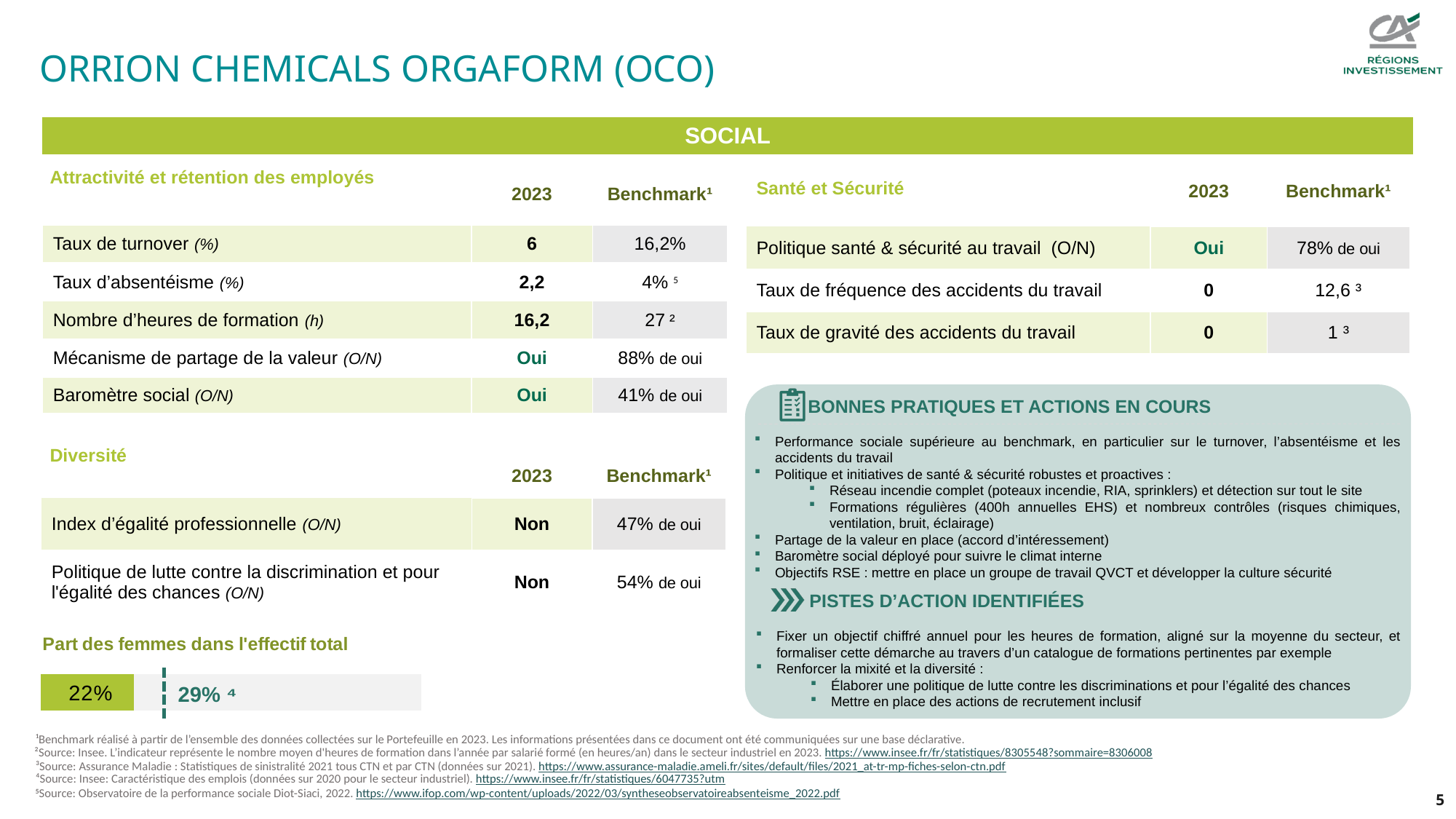
In the 'Part des femmes dans l'effectif total' chart, what is the benchmark value marked by the dashed line? 29% In the 'Part des femmes dans l'effectif total' chart, which is larger: the company's share of women or the benchmark? the benchmark (29%) In the 'Part des femmes dans l'effectif total' chart, what colour is the bar showing the company's 22% value? green In the 'Part des femmes dans l'effectif total' chart, what is the company's share of women in the total workforce? 22% What is the title of the chart at the bottom left of the slide? Part des femmes dans l'effectif total How many bars are plotted in the 'Part des femmes dans l'effectif total' chart? 2 In the 'Part des femmes dans l'effectif total' chart, what is the difference between the benchmark (29%) and the company's value (22%)? 7% What kind of chart is used for 'Part des femmes dans l'effectif total'? bar chart